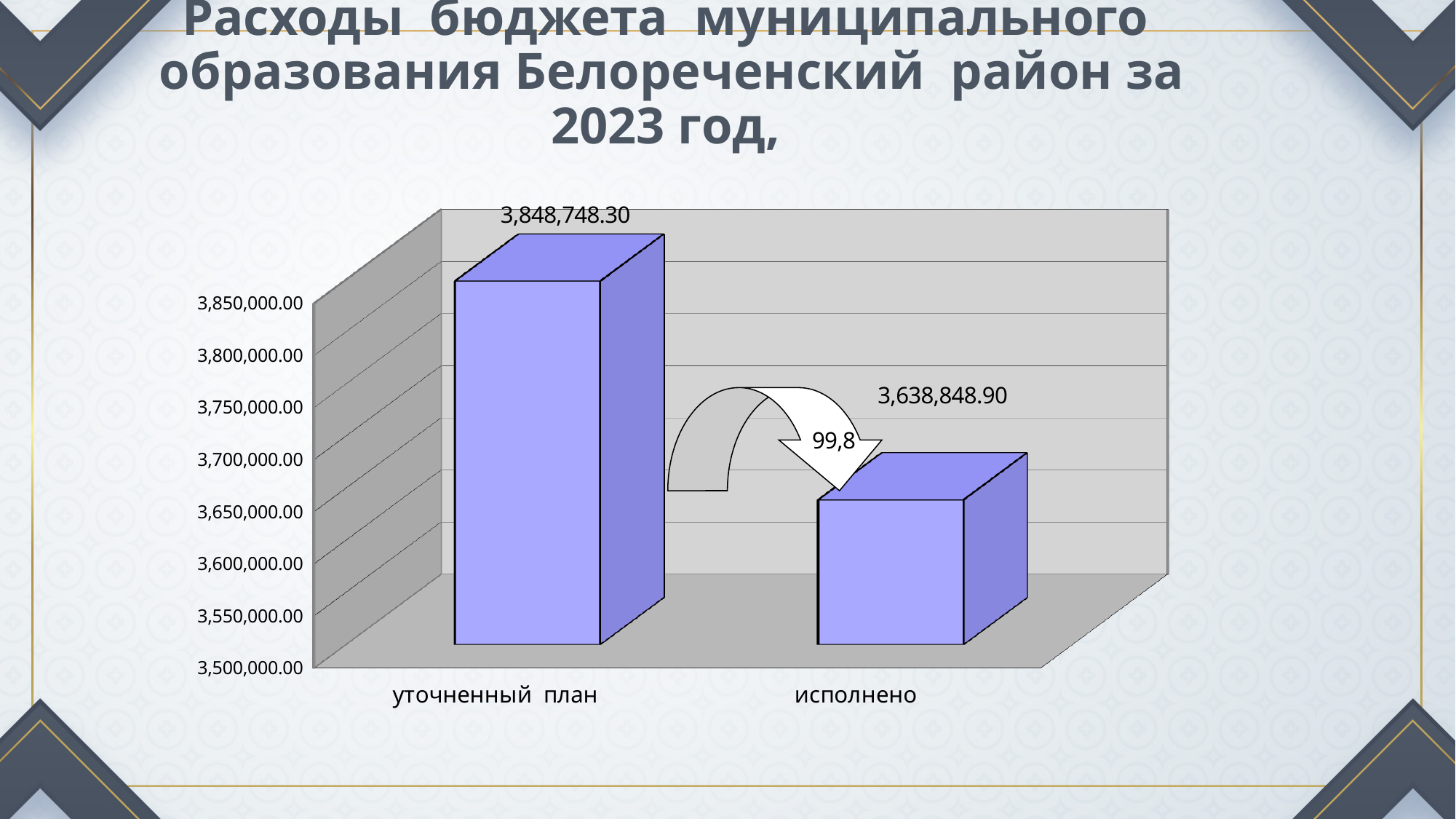
What kind of chart is shown on the slide? bar chart Which category has the lowest value? исполнено What is the difference between the values for "уточненный план" and "исполнено"? 209,899.40 Is the value for "уточненный план" greater or less than 3,800,000.00? greater Is the value for "исполнено" greater or less than 3,650,000.00? less What is the value for "уточненный план"? 3,848,748.30 Which category has the highest value? уточненный план How many categories are shown on the x axis? 2 What is the value for "исполнено"? 3,638,848.90 What number is printed on the arrow between the two bars? 99,8 Do the values rise or fall from "уточненный план" to "исполнено"? fall Which is larger, the value for "уточненный план" or the value for "исполнено"? уточненный план